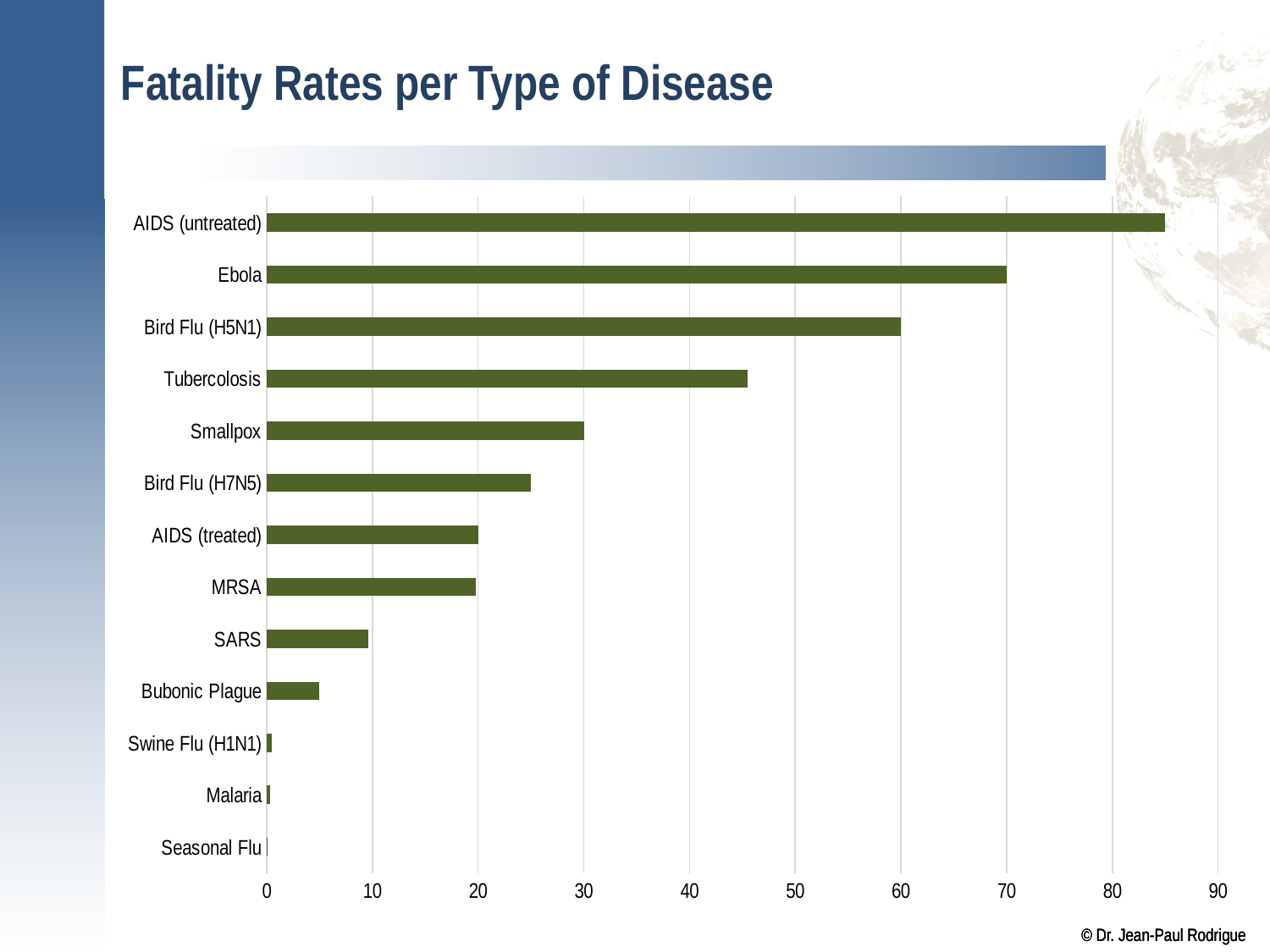
Which has the higher fatality rate, Smallpox or Bird Flu (H7N5)? Smallpox What kind of chart is shown on the slide? bar chart What is the fatality rate shown for Smallpox? 30 What is the difference between the fatality rates of Ebola and Bird Flu (H5N1)? 10 What is the title of the chart? Fatality Rates per Type of Disease Is the value for AIDS (untreated) greater or less than 80? greater What is the fatality rate shown for Bird Flu (H5N1)? 60 What is the fatality rate shown for AIDS (treated)? 20 Is the value for Tubercolosis greater or less than 50? less How many diseases are plotted in the chart? 13 Which disease has the highest fatality rate in the chart? AIDS (untreated) What is the fatality rate shown for Ebola? 70